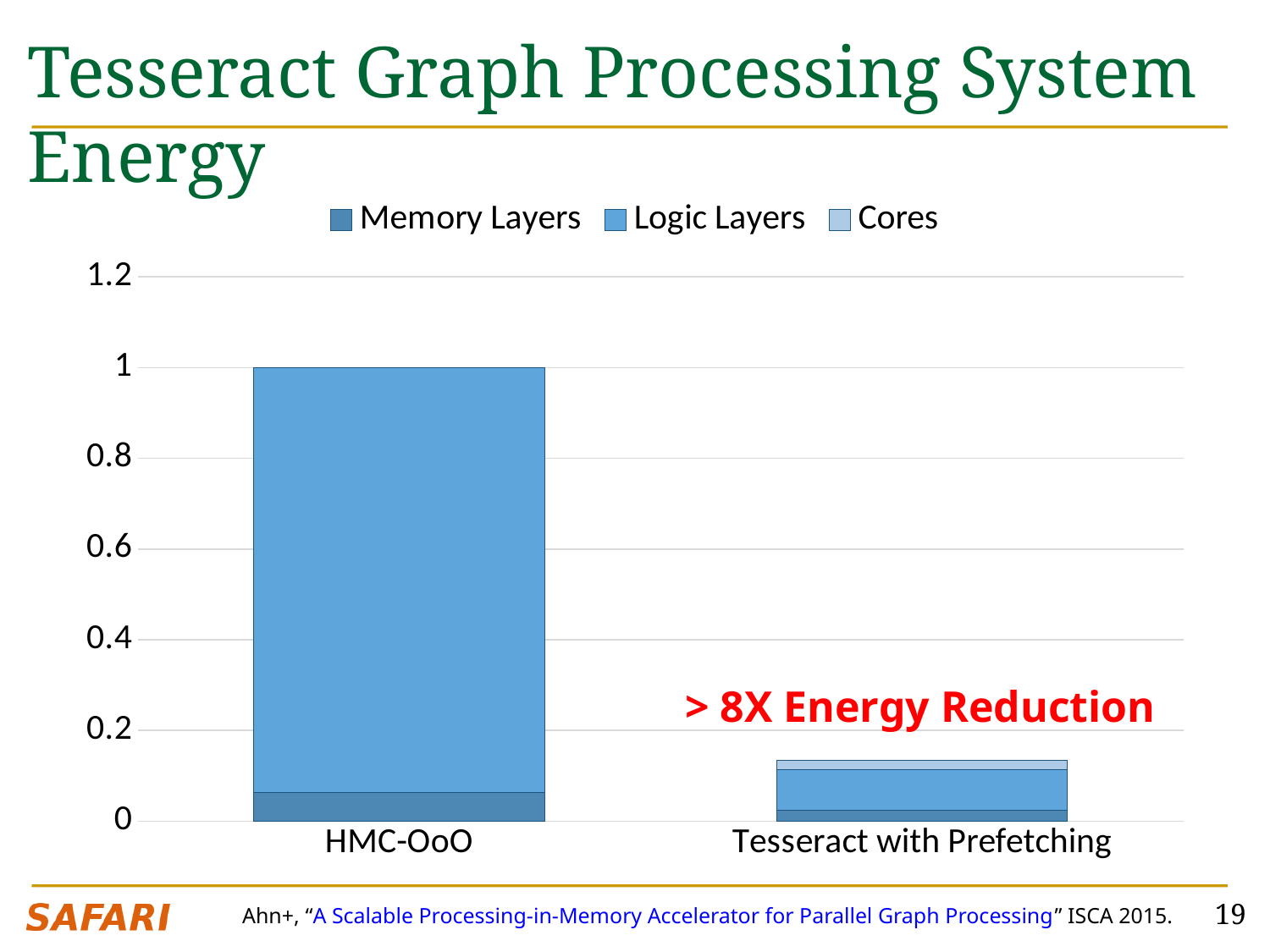
How many categories are shown on the x axis of the chart? 2 What kind of chart is shown on the slide? stacked bar chart Which has a larger total energy, HMC-OoO or Tesseract with Prefetching? HMC-OoO Which category has the highest total energy in the chart? HMC-OoO What does the red annotation on the chart say? > 8X Energy Reduction Which category has the lowest total energy in the chart? Tesseract with Prefetching Is the total value for HMC-OoO greater or less than 0.8? greater What is the total height of the HMC-OoO stacked bar? 1 What are the three series listed in the chart legend? Memory Layers, Logic Layers, Cores How many series does the chart legend list? 3 Is the total value for Tesseract with Prefetching greater or less than 0.2? less Which series makes up the largest portion of the HMC-OoO bar? Logic Layers